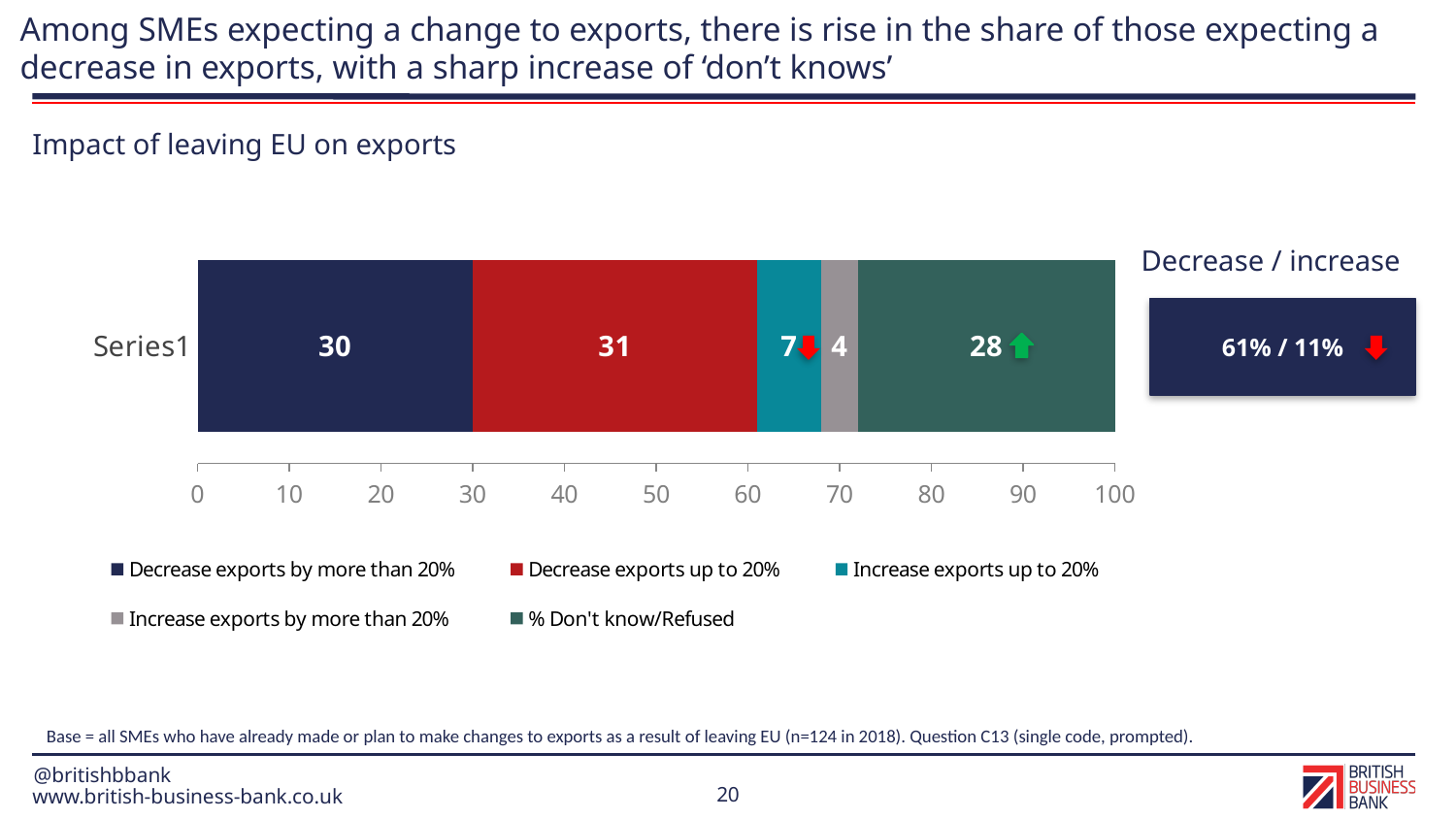
What is the difference between the values for 'Decrease exports by more than 20%' and '% Don't know/Refused'? 2 Which series has the smallest value in the bar? Increase exports by more than 20% What is the value for 'Increase exports by more than 20%'? 4 What is the total of the stacked bar? 100 What is the value for 'Decrease exports up to 20%'? 31 How many series does the legend list? 5 What is the value for '% Don't know/Refused'? 28 What kind of chart is shown on the slide? Stacked bar chart Which series has the largest value in the bar? Decrease exports up to 20% What is the value for 'Increase exports up to 20%'? 7 What is the value for 'Decrease exports by more than 20%'? 30 What is the title of the chart? Impact of leaving EU on exports